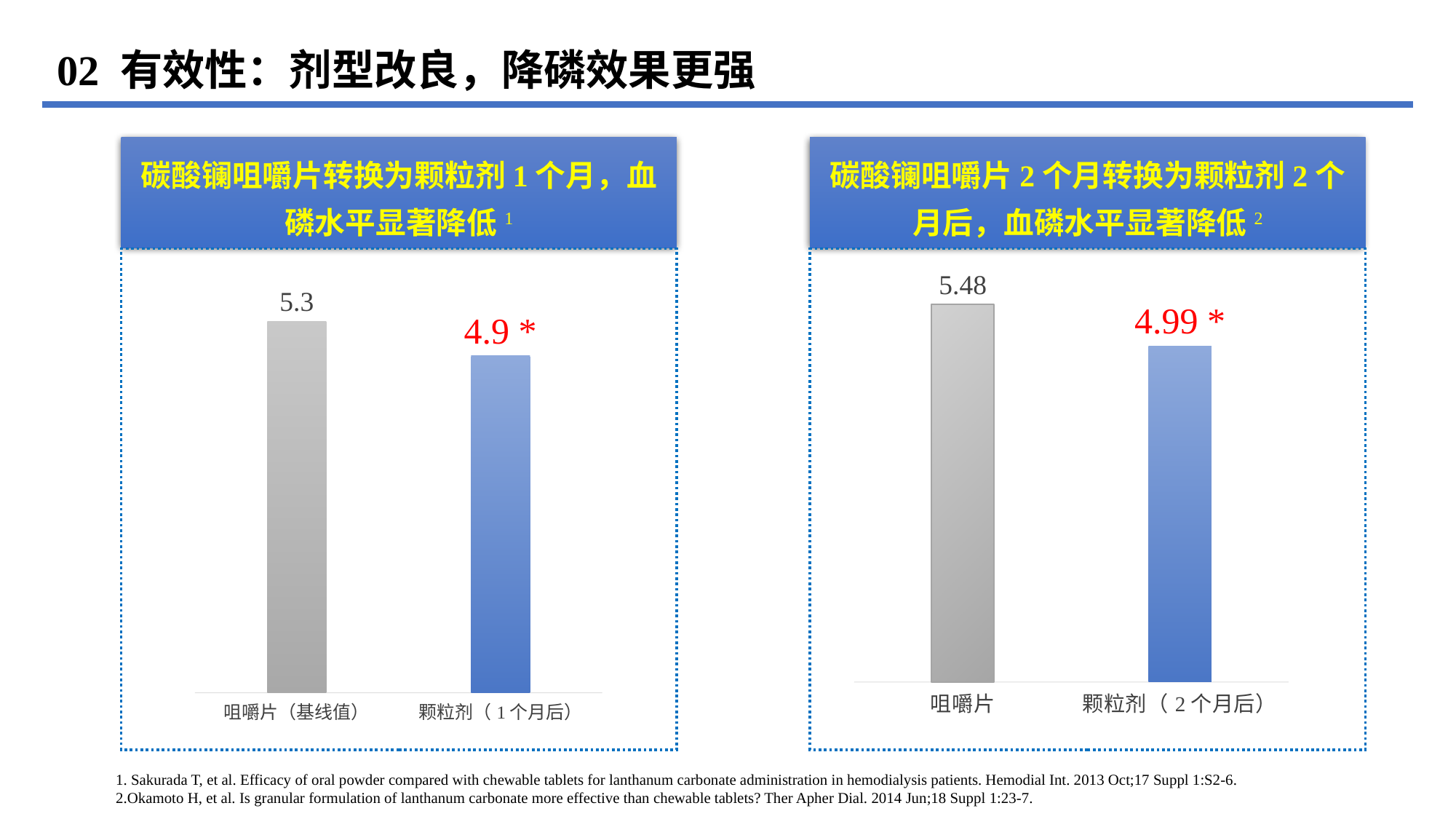
In the left chart, what is the value for 咀嚼片（基线值）? 5.3 What type of chart is the right chart? bar chart In the right chart, is the value for 咀嚼片 larger or smaller than the value for 颗粒剂（2个月后）? larger In the right chart, which category has the lower value? 颗粒剂（2个月后） In the left chart, which category has the higher value? 咀嚼片（基线值） In the left chart, what colour is the bar for 颗粒剂（1个月后）? blue In the right chart, what is the value for 颗粒剂（2个月后）? 4.99 In the left chart, what is the value for 颗粒剂（1个月后）? 4.9 How many bars are shown in the left chart? 2 In the right chart, what is the difference between the value for 咀嚼片 and the value for 颗粒剂（2个月后）? 0.49 In the right chart, what is the value for 咀嚼片? 5.48 In the left chart, what is the difference between the value for 咀嚼片（基线值） and the value for 颗粒剂（1个月后）? 0.4